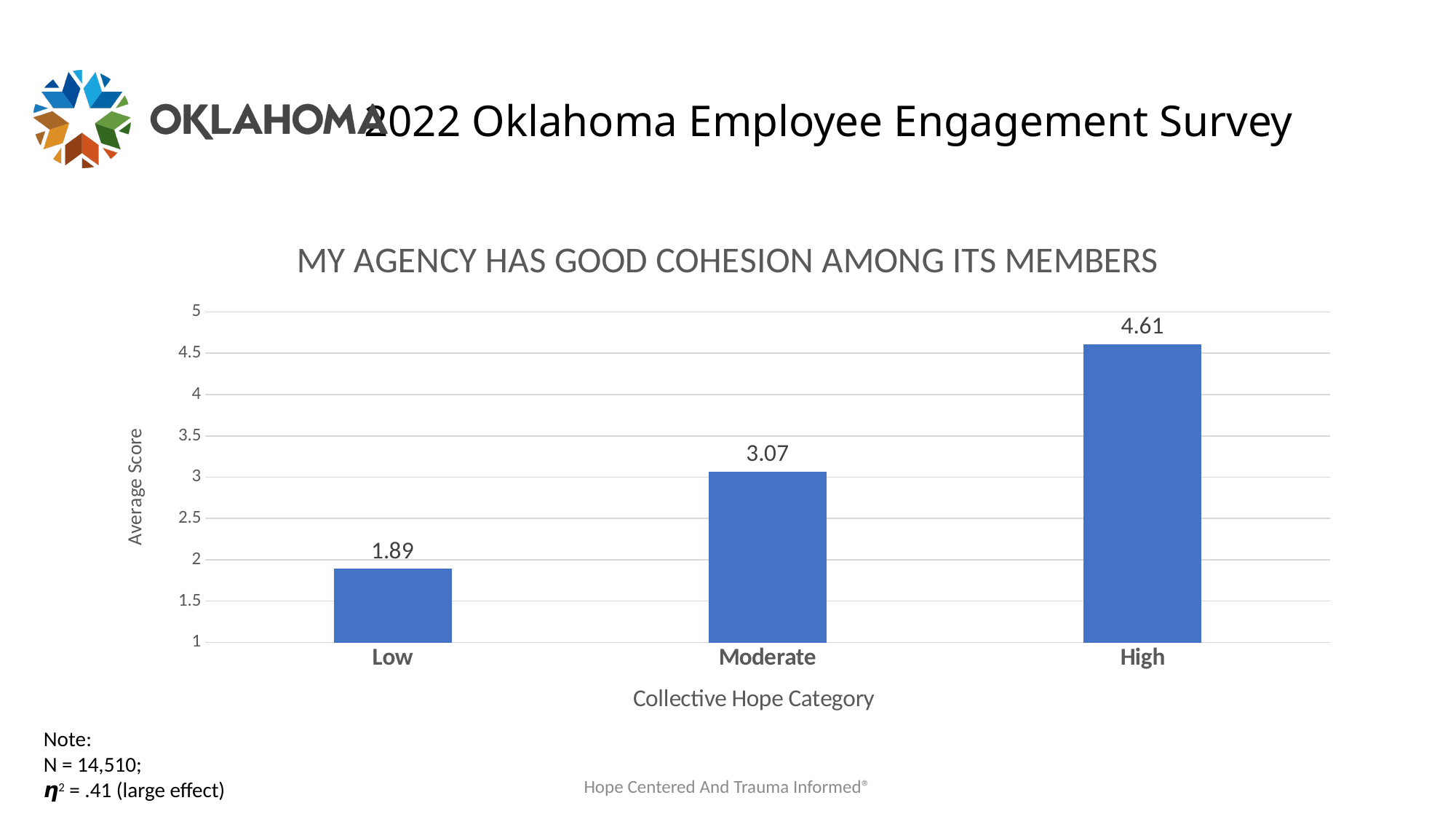
How many collective hope categories are shown on the chart? 3 What is the average score for the Moderate collective hope category? 3.07 Which collective hope category has the lowest average score? Low What is the average score for the Low collective hope category? 1.89 Which has a higher average score, Moderate or High? High What kind of chart is shown on the slide? bar chart What is the difference between the average scores for the Moderate and Low categories? 1.18 Which collective hope category has the highest average score? High Is the average score for the Moderate category greater or less than 3.5? less Do the average scores rise or fall from Low to High along the x axis? rise What is the difference between the average scores for the High and Low categories? 2.72 What is the average score for the High collective hope category? 4.61